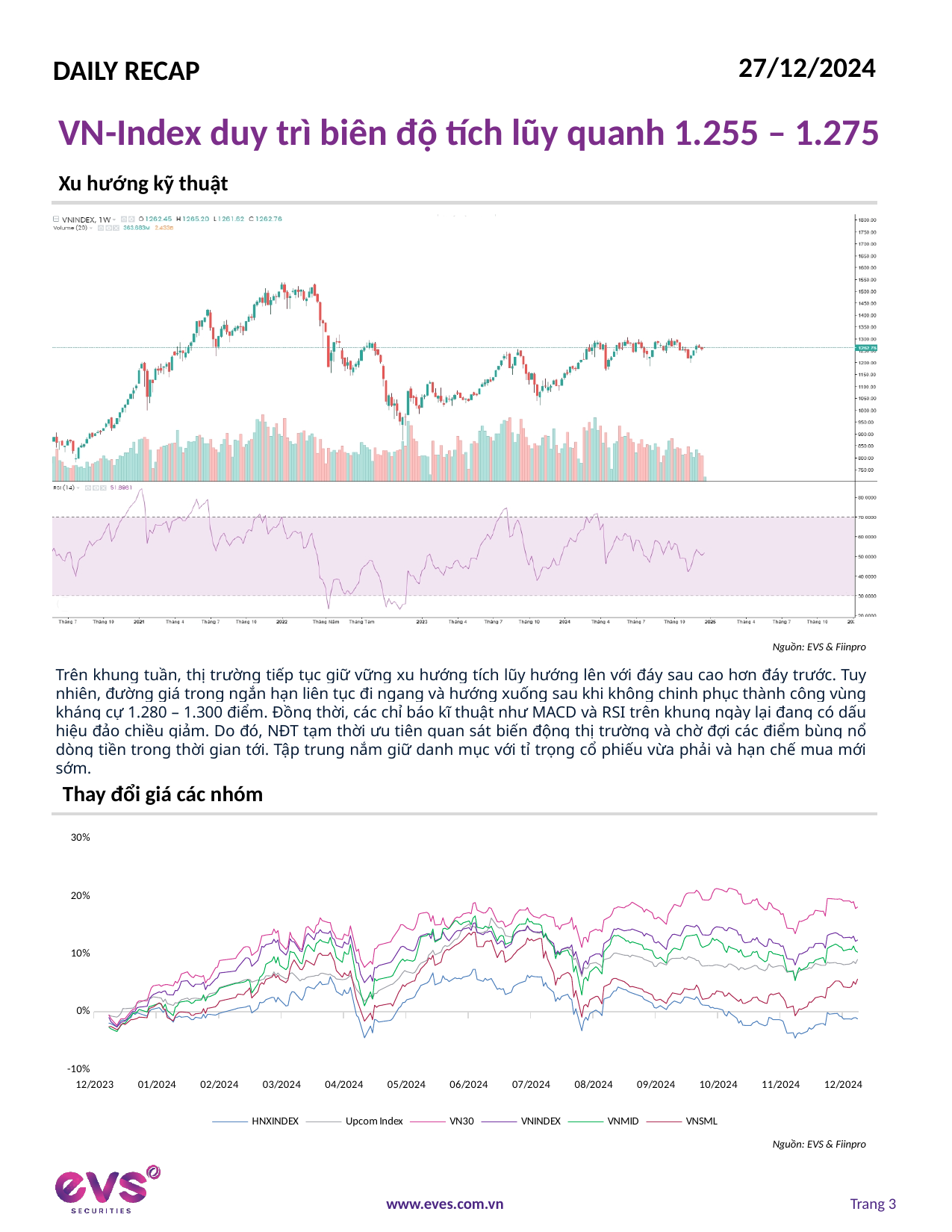
What kind of chart is the 'Thay đổi giá các nhóm' chart at the bottom of the slide? line chart In the 'Thay đổi giá các nhóm' chart, is the value for VNSML at 12/2024 greater or less than 10%? less In the 'Thay đổi giá các nhóm' chart, which series is lowest at the end of the period (12/2024)? HNXINDEX How many month labels are shown on the x axis of the 'Thay đổi giá các nhóm' chart? 13 What source is cited below the 'Thay đổi giá các nhóm' chart? EVS & Fiinpro In the 'Thay đổi giá các nhóm' chart, does the VN30 series overall rise or fall from 12/2023 to 12/2024? rise In the 'Thay đổi giá các nhóm' chart, is the value for HNXINDEX at 12/2024 greater or less than 10%? less What kind of chart is the top chart under 'Xu hướng kỹ thuật'? candlestick chart In the 'Thay đổi giá các nhóm' chart, which series is highest at the end of the period (12/2024)? VN30 In the 'Thay đổi giá các nhóm' chart, is the value for VN30 at 12/2024 greater or less than 10%? greater How many series does the legend of the 'Thay đổi giá các nhóm' chart list? 6 In the 'Thay đổi giá các nhóm' chart, which is larger at 12/2024: VN30 or HNXINDEX? VN30